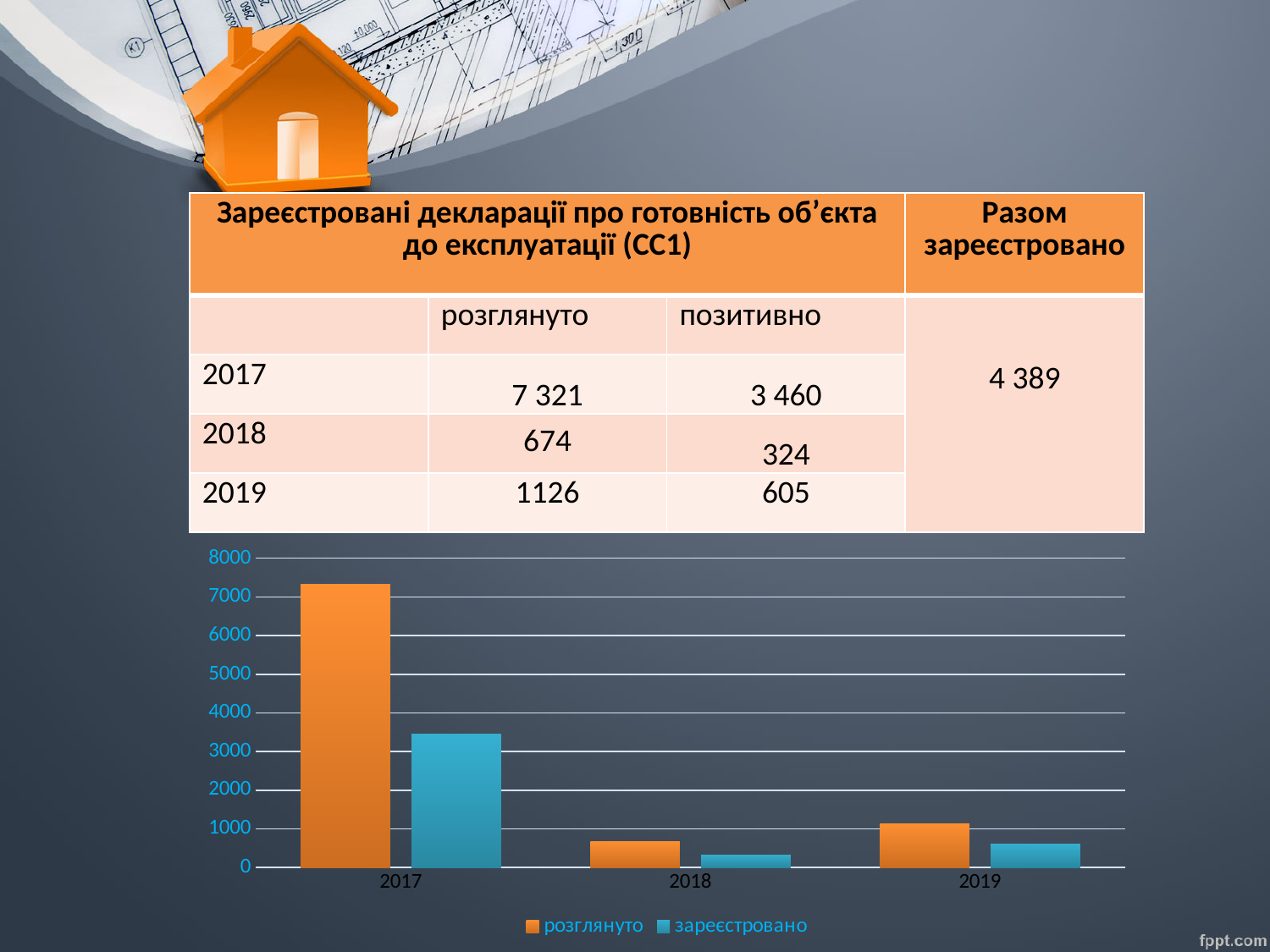
What kind of chart is shown at the bottom of the slide? bar chart Which year has the lowest value for зареєстровано in the chart? 2018 How many years are shown on the x axis of the chart? 3 Is the value for розглянуто in 2017 greater or less than 7000? greater Which year has the highest value for розглянуто in the chart? 2017 Is the value for зареєстровано in 2019 greater or less than 1000? less Which year has the lowest value for розглянуто in the chart? 2018 How many series does the chart legend list? 2 Does the value for розглянуто rise or fall from 2017 to 2018? fall Is the value for розглянуто in 2018 greater or less than 1000? less Which is larger in the chart: розглянуто in 2019 or розглянуто in 2018? розглянуто in 2019